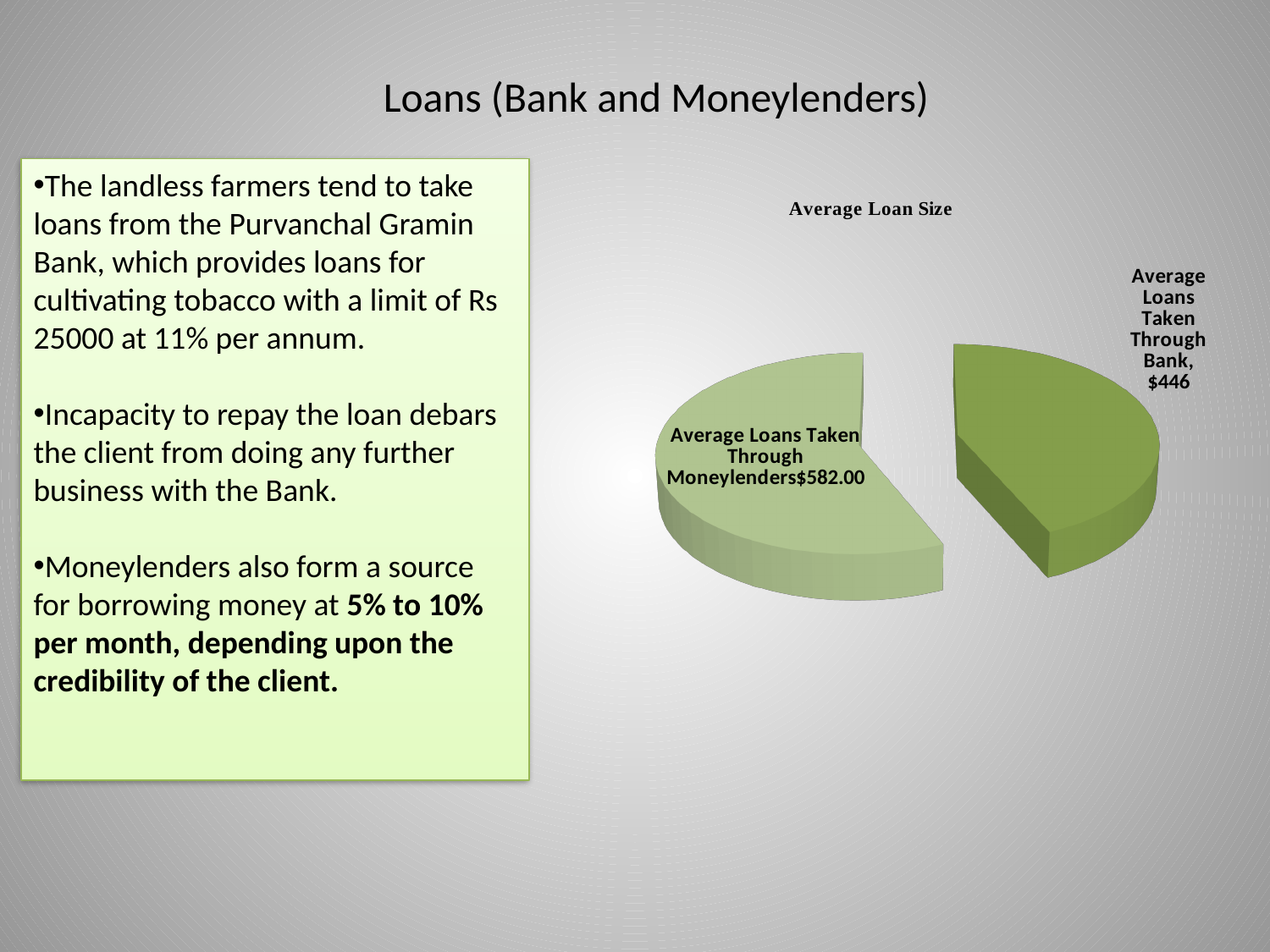
Which is larger, the average loan taken through the Bank or through Moneylenders? Moneylenders What is the title of the chart? Average Loan Size What is the value shown for Average Loans Taken Through Moneylenders? $582.00 Which slice of the pie chart is the largest? Average Loans Taken Through Moneylenders What type of chart is shown on the slide? pie chart What is the difference between the average loan taken through Moneylenders and through the Bank? $136 How many slices does the pie chart have? 2 Which slice of the pie chart is the smallest? Average Loans Taken Through Bank Which slice is drawn in the darker green colour? Average Loans Taken Through Bank What is the value shown for Average Loans Taken Through Bank? $446